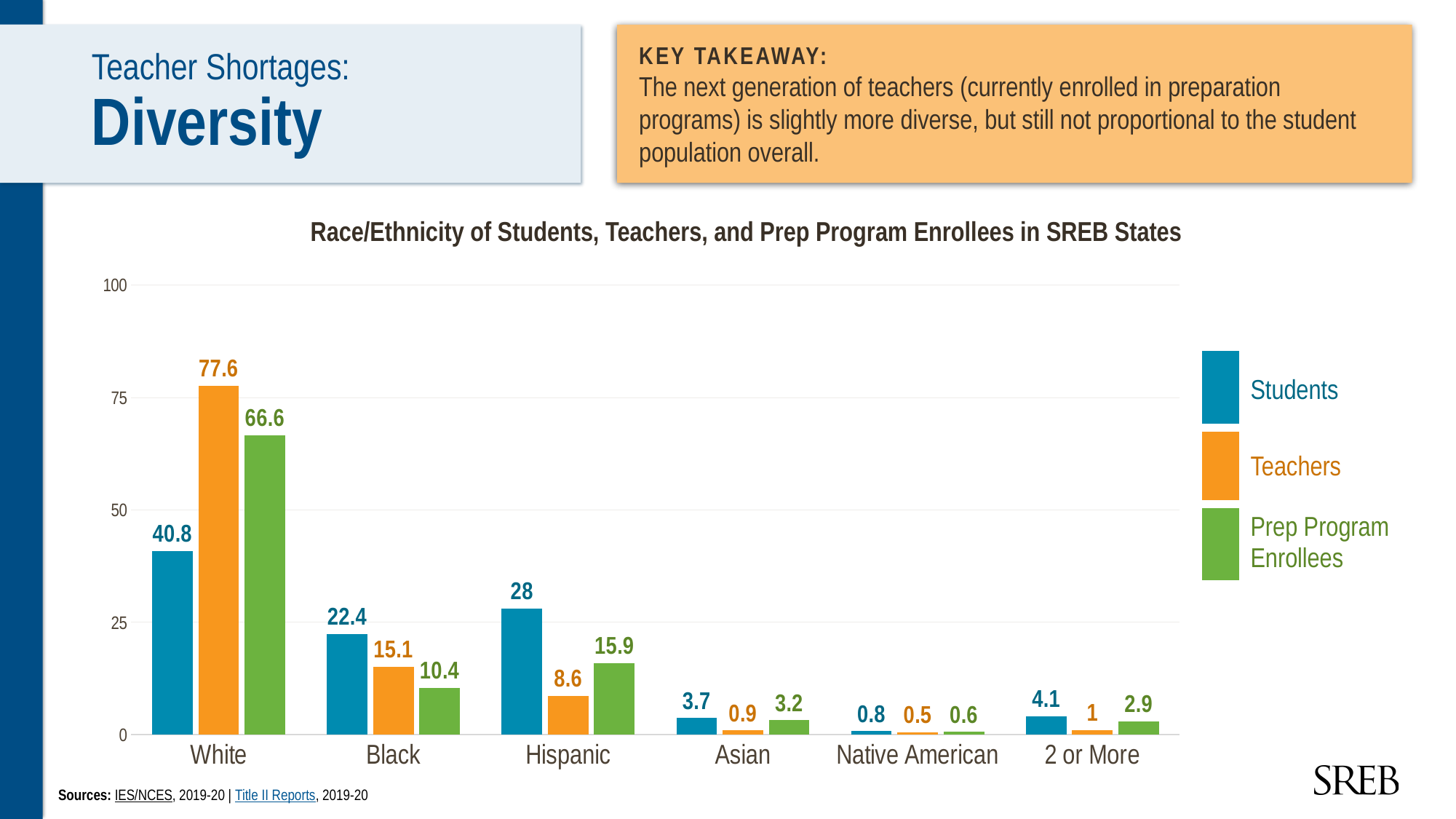
What is the difference between the Teachers value and the Students value in the White category? 36.8 How many series does the legend list? 3 Which category has the highest value for Teachers? White What kind of chart is shown on the slide? Bar chart What is the value for Students in the White category? 40.8 What is the value for Prep Program Enrollees in the Black category? 10.4 How many race/ethnicity categories are shown on the x axis? 6 Is the value for Teachers in the White category greater or less than 75? greater What is the title of the chart? Race/Ethnicity of Students, Teachers, and Prep Program Enrollees in SREB States Which category has the lowest value for Students? Native American What is the value for Teachers in the Hispanic category? 8.6 In the Hispanic category, which is larger: the Students value or the Prep Program Enrollees value? Students